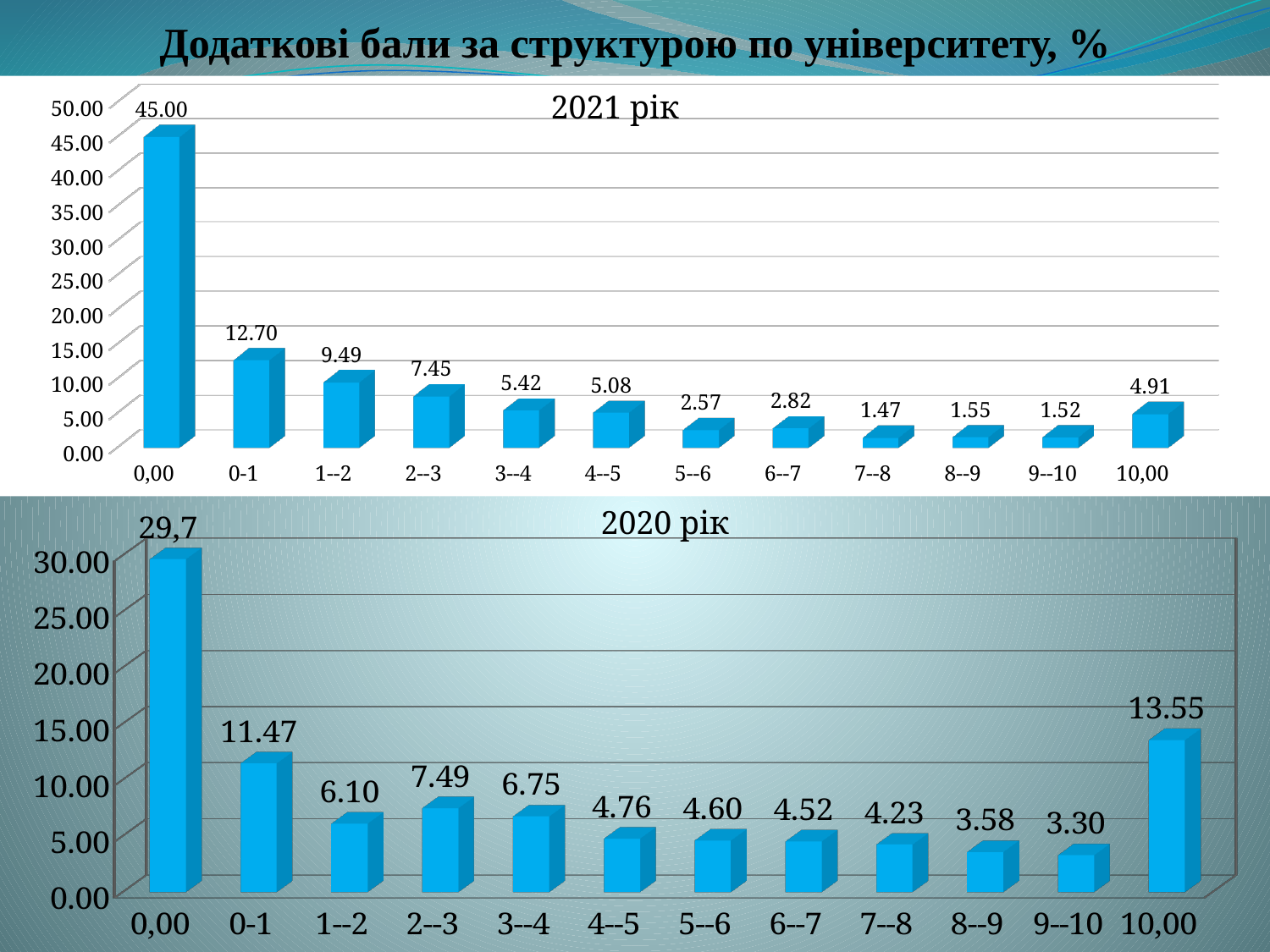
In the "2020 рік" chart, what is the difference between the values for 0-1 and 1--2? 5.37 In the "2021 рік" chart, what is the value for the category 3--4? 5.42 In the "2020 рік" chart, which category has the lowest value? 9--10 What is the title of the slide? Додаткові бали за структурою по університету, % In the "2020 рік" chart, what is the value for the category 10,00? 13.55 In the "2021 рік" chart, which is larger: the value for 2--3 or the value for 10,00? 2--3 How many categories are shown in the "2021 рік" chart? 12 What kind of chart is the "2020 рік" chart? bar chart In the "2021 рік" chart, which category has the lowest value? 7--8 In the "2020 рік" chart, is the value for 0,00 greater or less than 25.00? greater In the "2021 рік" chart, what is the value for the category 0-1? 12.70 In the "2021 рік" chart, which category has the highest value? 0,00